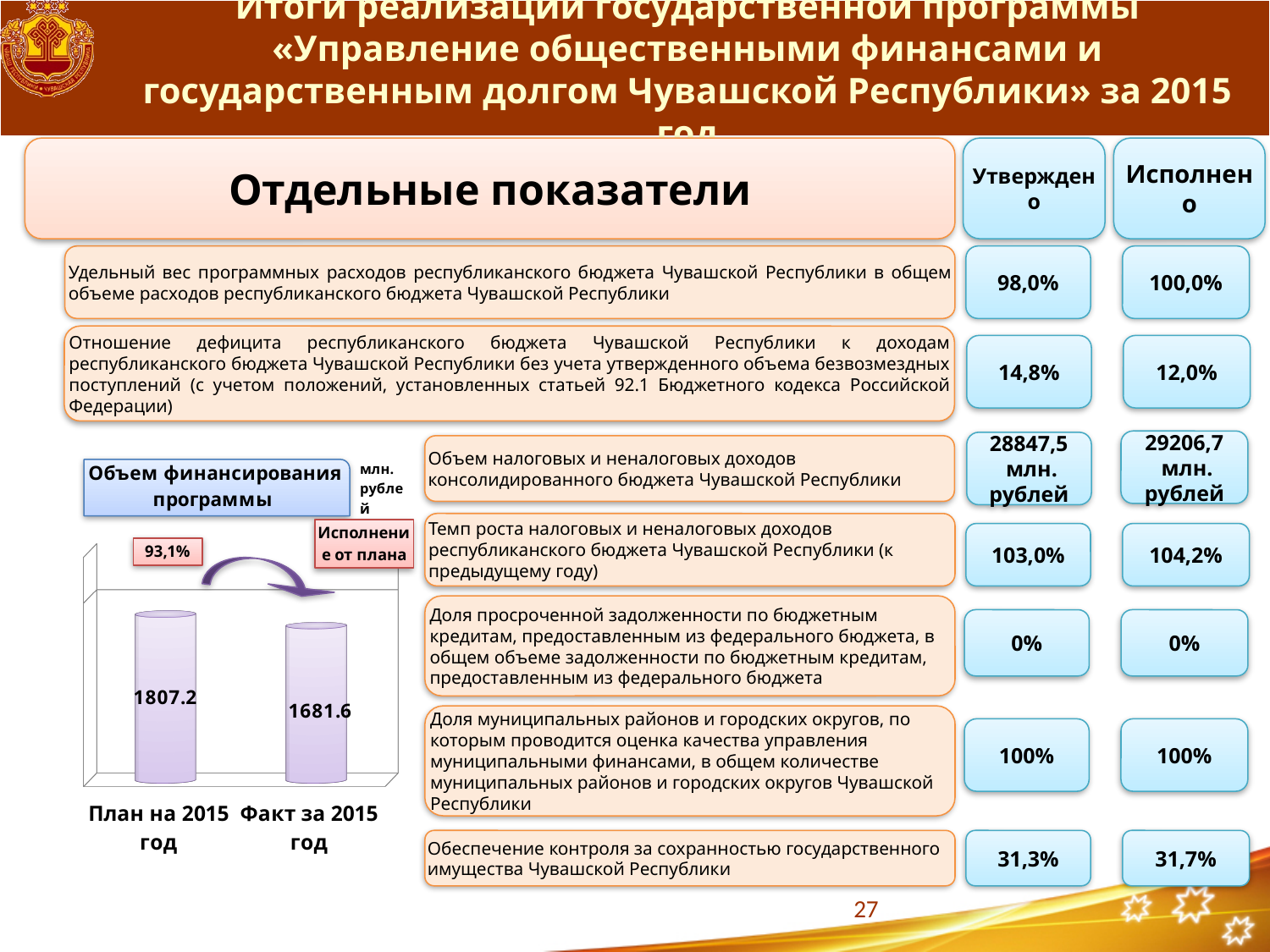
What is the value for "Факт за 2015 год" in the "Объем финансирования программы" chart? 1681.6 What unit is indicated for the values in the "Объем финансирования программы" chart? млн. рублей What is the difference between the values for "План на 2015 год" and "Факт за 2015 год" in the "Объем финансирования программы" chart? 125.6 What percentage is shown as "Исполнение от плана" on the "Объем финансирования программы" chart? 93,1% Do the values in the "Объем финансирования программы" chart rise or fall from "План на 2015 год" to "Факт за 2015 год"? fall What is the value for "План на 2015 год" in the "Объем финансирования программы" chart? 1807.2 Which category has the highest value in the "Объем финансирования программы" chart? План на 2015 год How many bars are shown in the "Объем финансирования программы" chart? 2 In the "Объем финансирования программы" chart, which is larger: "План на 2015 год" or "Факт за 2015 год"? План на 2015 год What kind of chart is "Объем финансирования программы"? bar chart Which category has the lowest value in the "Объем финансирования программы" chart? Факт за 2015 год